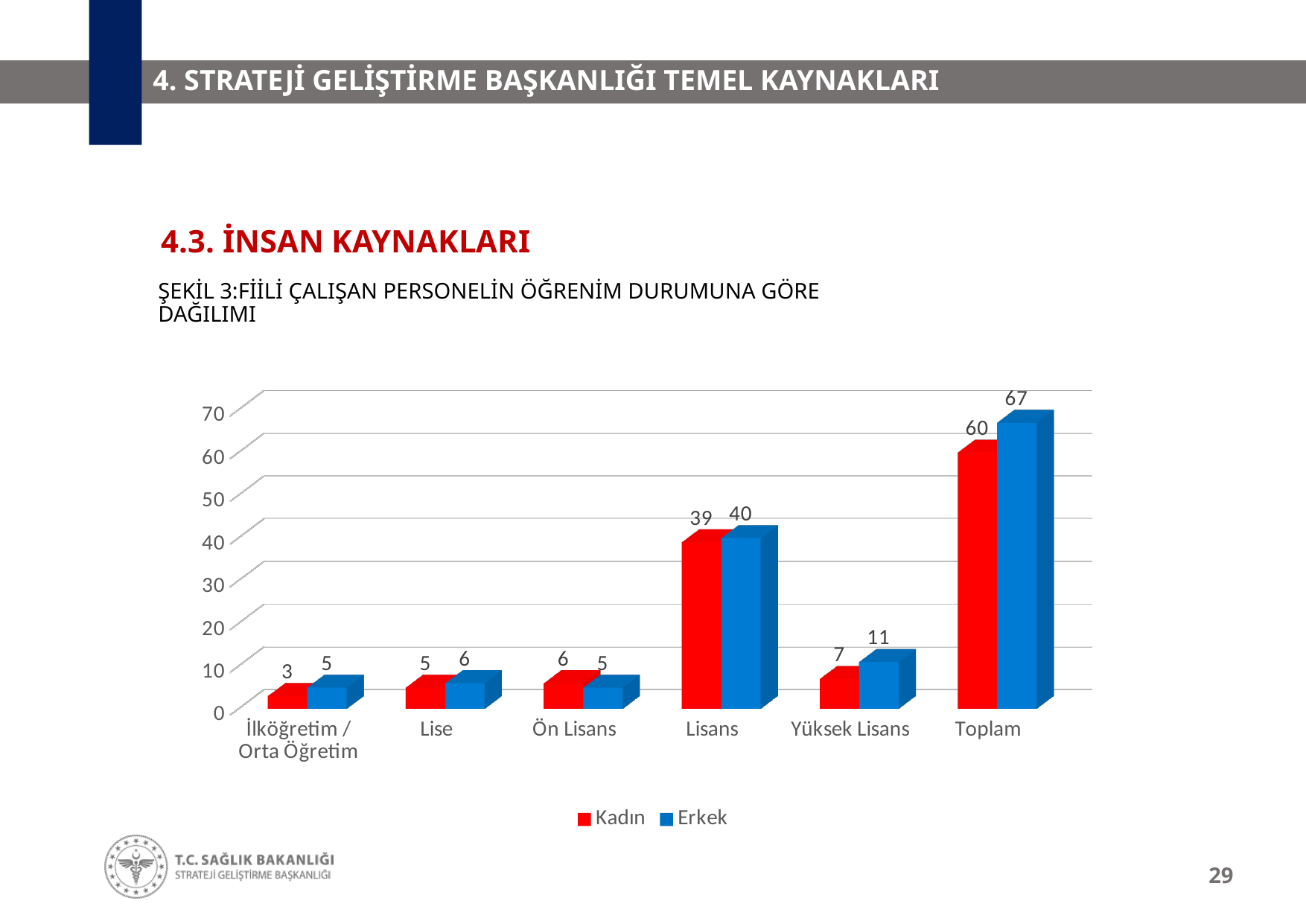
What is the Kadın value for İlköğretim / Orta Öğretim? 3 What is the Kadın value for Lisans? 39 Which category has the lowest Kadın value? İlköğretim / Orta Öğretim How many series does the legend list? 2 What kind of chart is shown on the slide? bar chart Excluding Toplam, which category has the highest Erkek value? Lisans What is the Erkek value for Yüksek Lisans? 11 Is the Kadın value for Toplam greater or less than 50? greater What is the difference between the Erkek and Kadın values for Toplam? 7 How many categories are shown on the x axis? 6 What is the Erkek value for Toplam? 67 For Ön Lisans, which is larger, the Kadın value or the Erkek value? Kadın